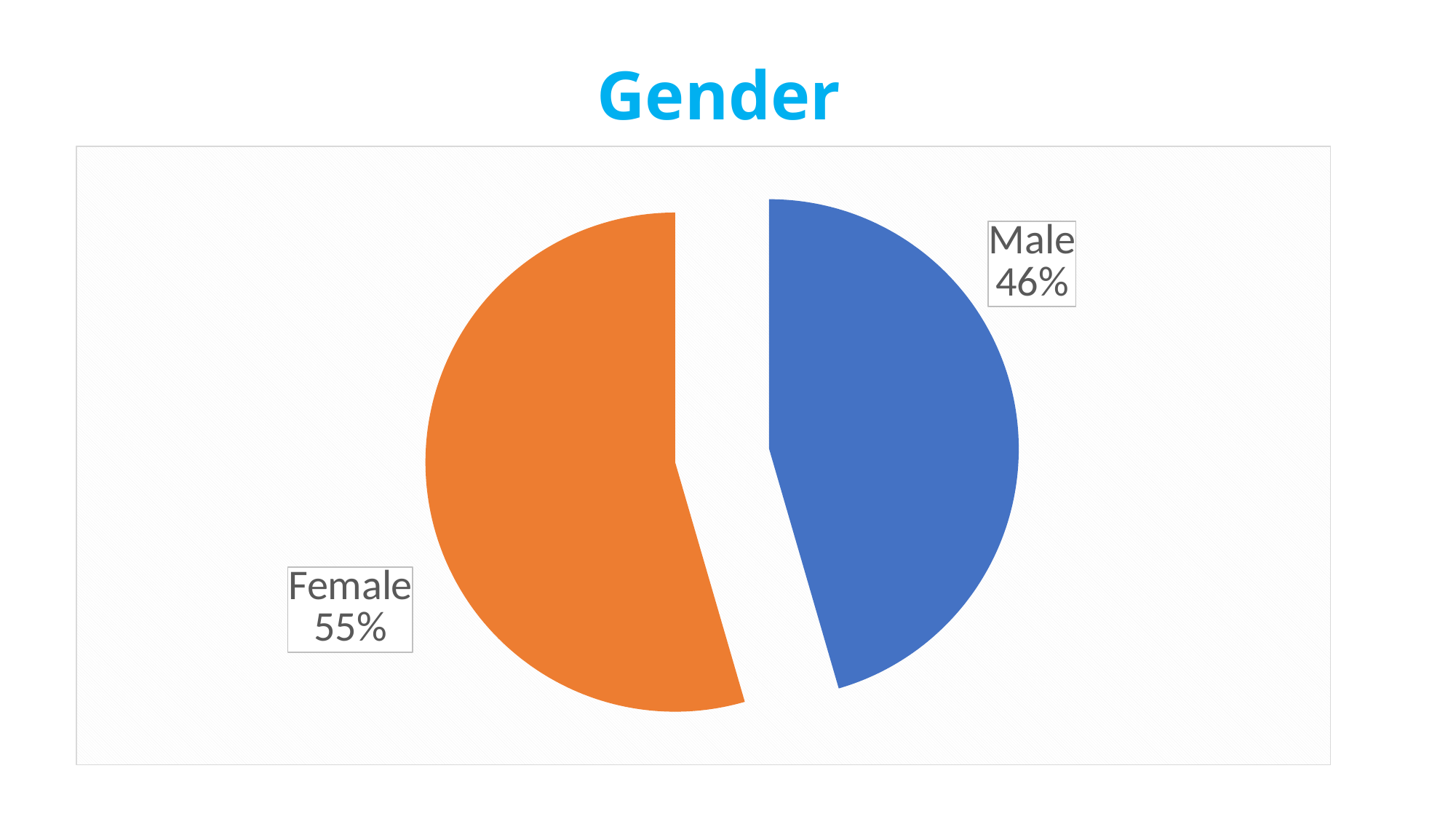
What kind of chart is shown on the slide? Pie chart Which category has the largest share of the pie chart? Female What colour is the Male slice? Blue Which slice is larger, Female or Male? Female What percentage of the pie chart is Female? 55% Which category has the smallest share of the pie chart? Male What is the title of the chart? Gender What is the difference in percentage points between the Female and Male slices? 9 What percentage of the pie chart is Male? 46% How many slices does the pie chart have? 2